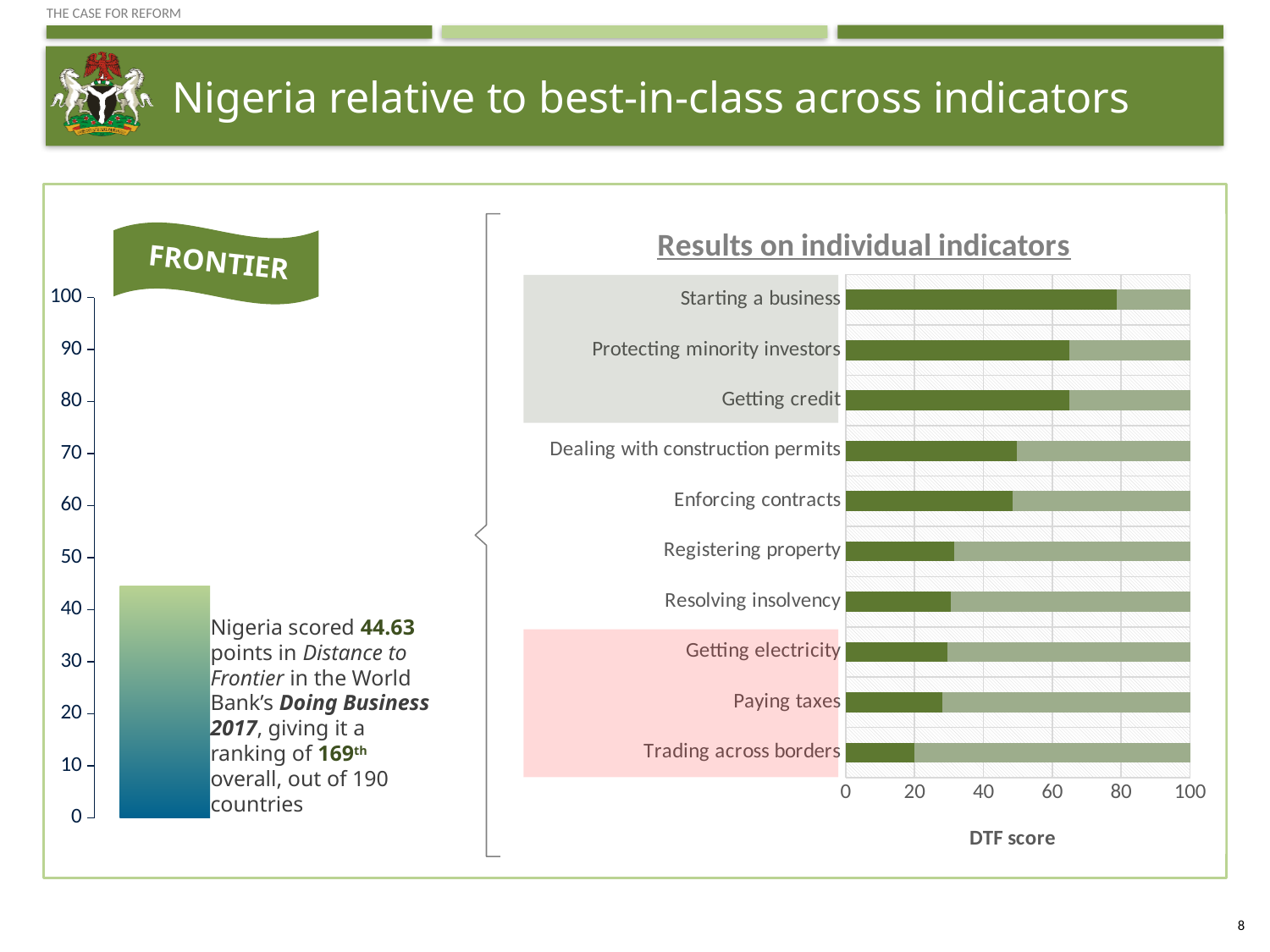
On the 'Results on individual indicators' chart, is the value for Starting a business greater or less than 60? greater What kind of chart is the 'Results on individual indicators' chart? bar chart How many indicators are shown on the 'Results on individual indicators' chart? 10 On the 'Results on individual indicators' chart, which indicator has the lowest DTF score? Trading across borders On the 'Results on individual indicators' chart, which has a higher DTF score: Paying taxes or Getting credit? Getting credit On the 'Results on individual indicators' chart, which indicator has the highest DTF score? Starting a business On the 'Results on individual indicators' chart, is the value for Trading across borders greater or less than 40? less On the 'Results on individual indicators' chart, is the value for Dealing with construction permits greater or less than 40? greater On the 'Results on individual indicators' chart, which has a higher DTF score: Starting a business or Registering property? Starting a business What is the x-axis title of the 'Results on individual indicators' chart? DTF score